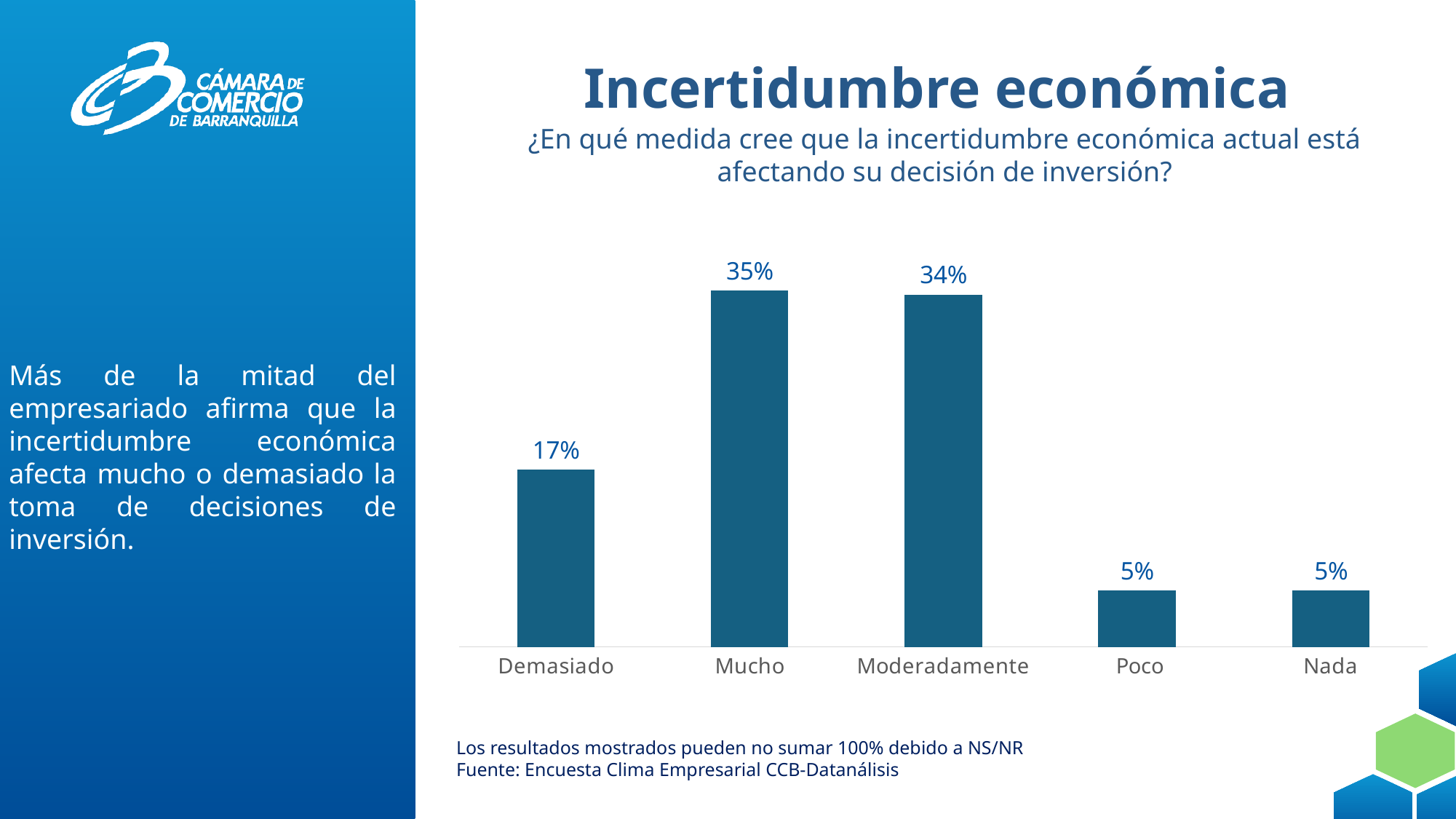
What kind of chart is shown on the slide? Bar chart What is the value for Poco? 5% What is the value for Moderadamente? 34% How many categories are shown on the x axis? 5 What is the difference between the values for Moderadamente and Poco? 29% Which category has the highest value? Mucho What is the value for Demasiado? 17% What is the title of the chart on the slide? Incertidumbre económica What is the value for Mucho? 35% What is the combined value of Demasiado and Mucho? 52% Which is larger, the value for Demasiado or the value for Nada? Demasiado What is the difference between the values for Mucho and Demasiado? 18%